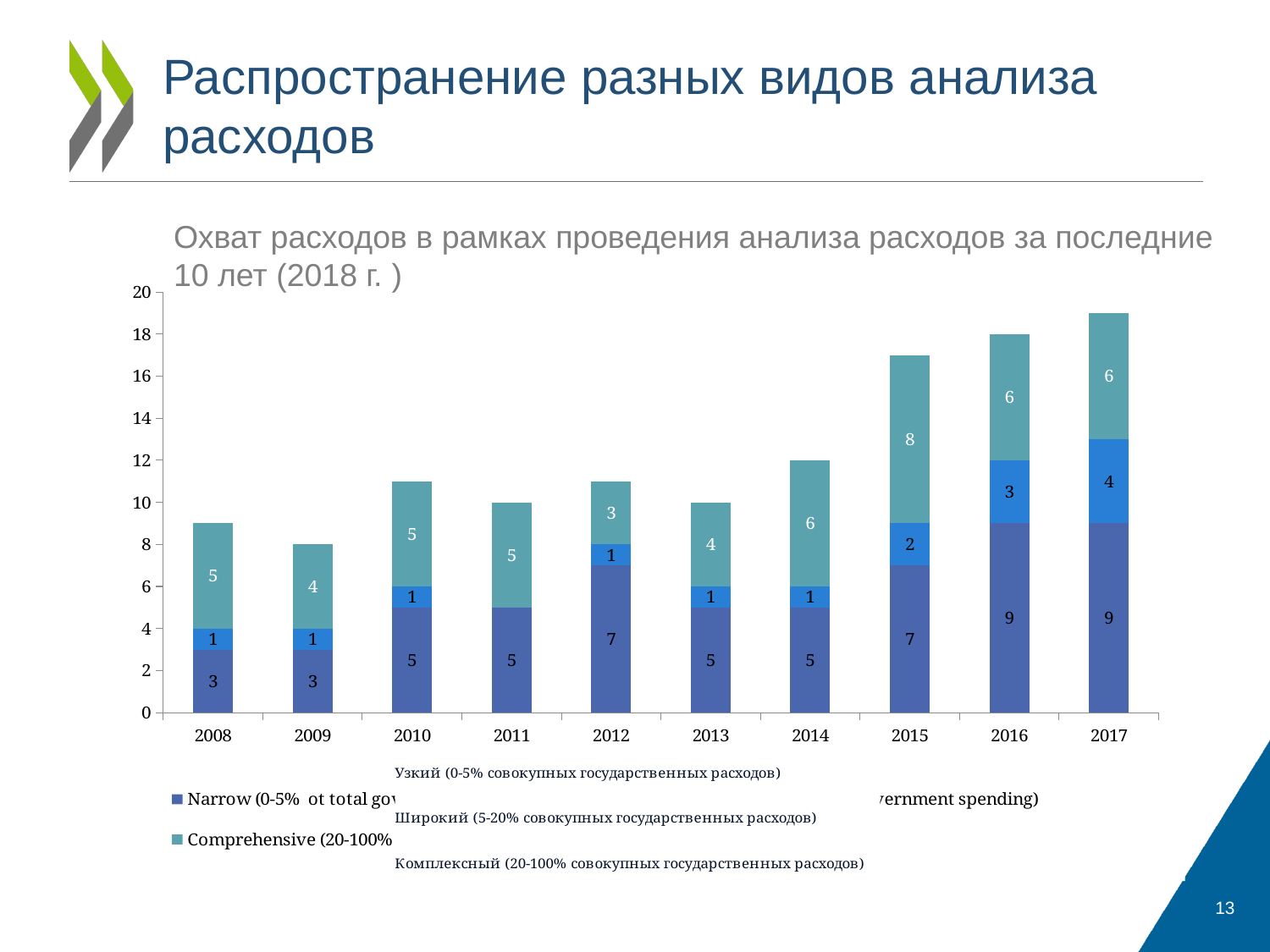
Which is larger: the Comprehensive segment in 2015 or in 2016? 2015 Which year has the shortest stacked bar? 2009 What is the difference between the Narrow segment in 2017 and the Narrow segment in 2008? 6 Which year has the tallest stacked bar? 2017 What is the total height of the stacked bar for 2008? 9 Is the total for 2015 greater or less than 16? greater What is the total height of the stacked bar for 2017? 19 How many years are shown on the x axis? 10 What is the value of the middle (5-20%) segment for 2016? 3 What is the value of the Narrow (0-5%) segment for 2017? 9 What is the value of the Comprehensive (20-100%) segment for 2015? 8 What kind of chart is shown on the slide? Stacked bar chart